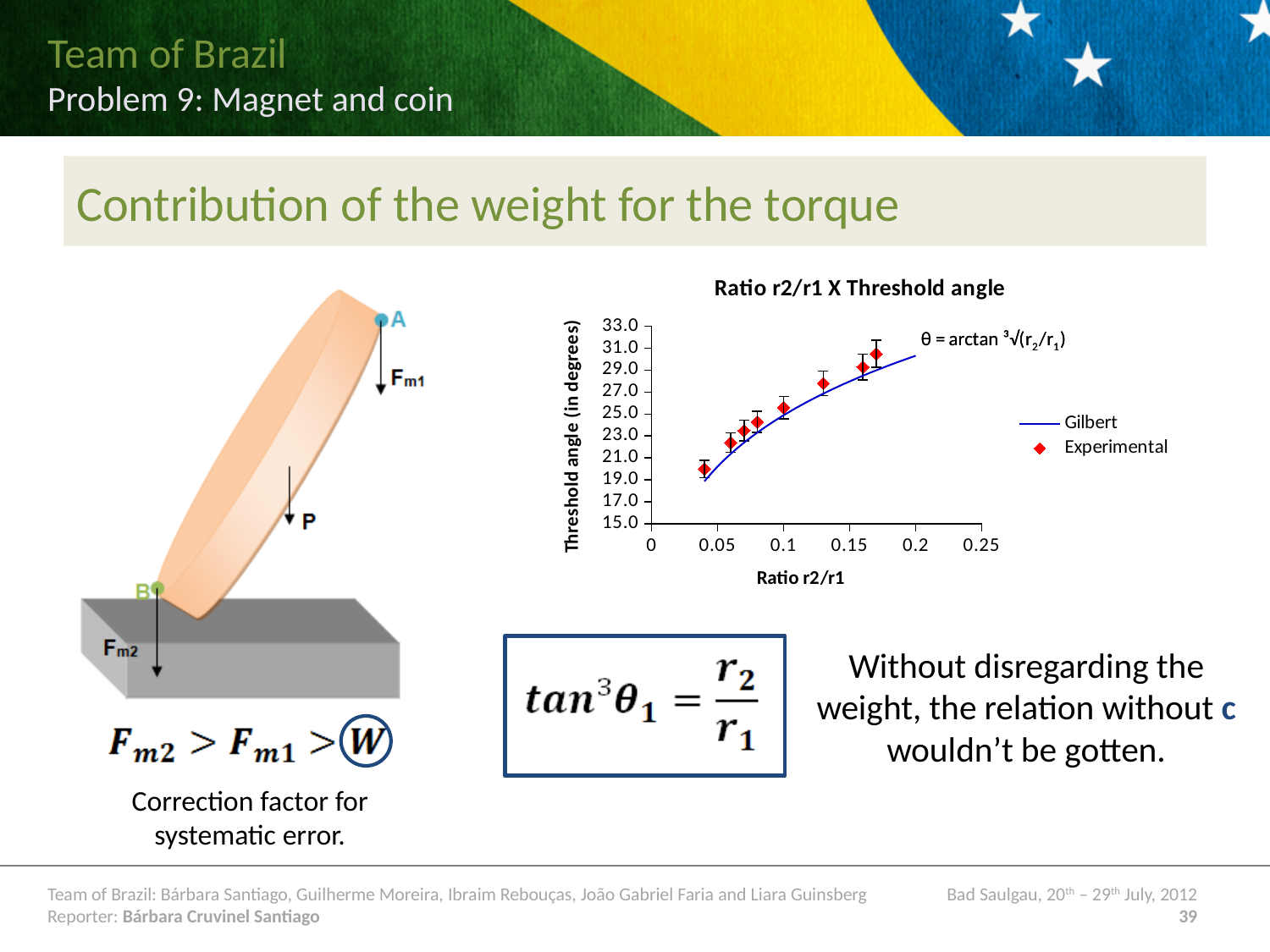
Is the experimental threshold angle at the smallest plotted ratio (about 0.04) greater or less than 21.0 degrees? less Which series in the chart is drawn as a line rather than as points? Gilbert What is the title of the chart? Ratio r2/r1 X Threshold angle Which is larger: the experimental threshold angle at ratio 0.1 or at ratio 0.16? at ratio 0.16 Is the experimental threshold angle at the largest plotted ratio (about 0.17) greater or less than 29.0 degrees? greater Is the experimental threshold angle at ratio 0.1 greater or less than 23.0 degrees? greater What is the highest value shown on the y axis of the chart? 33.0 What kind of chart is shown on the slide? scatter chart with a fitted line How many experimental data points are plotted in the chart? 8 Does the threshold angle rise or fall as the ratio r2/r1 increases? rise How many series does the legend of the chart list? 2